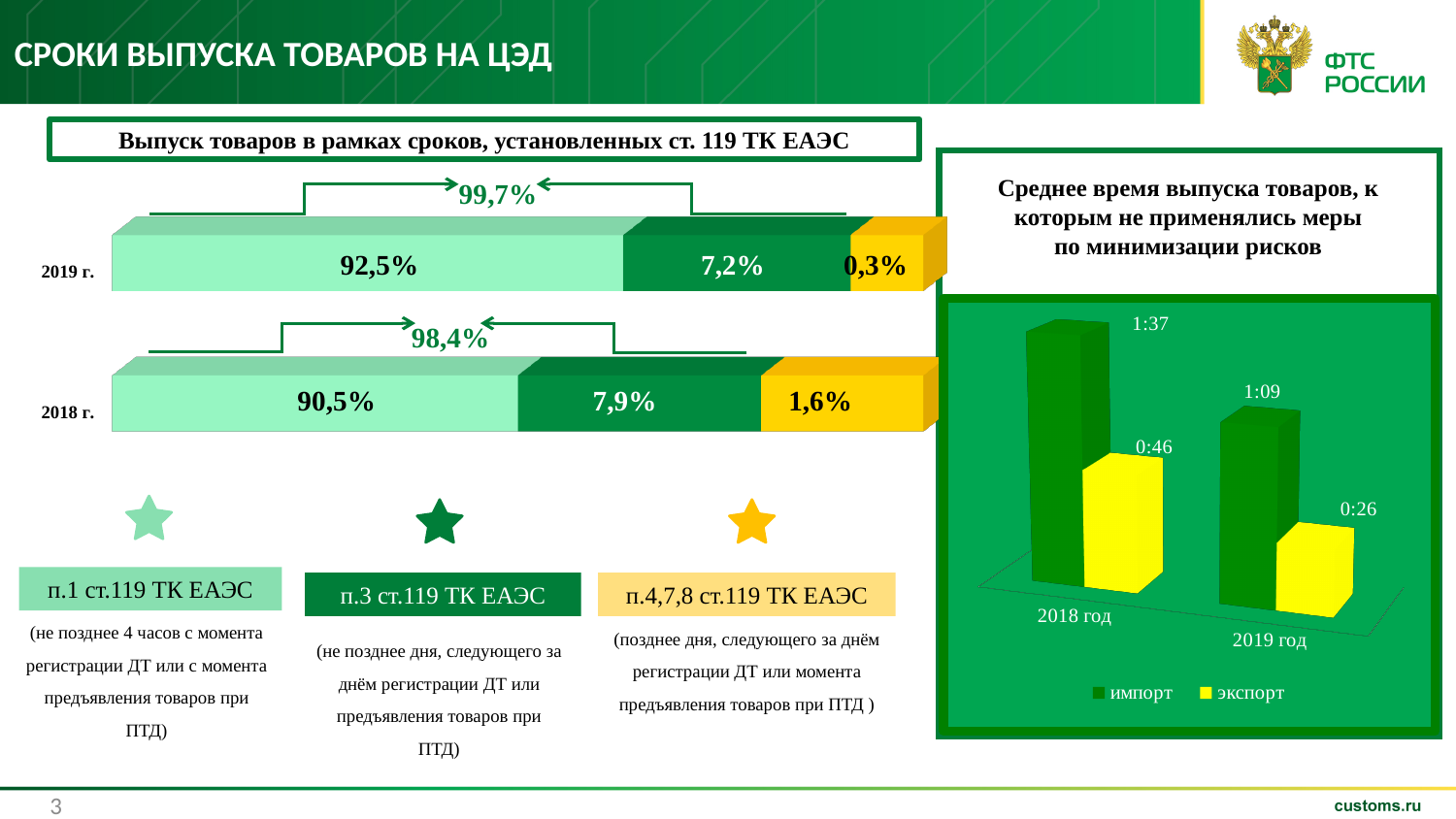
In the left chart 'Выпуск товаров в рамках сроков, установленных ст. 119 ТК ЕАЭС', what is the difference between the light green segments for 2019 г. and 2018 г.? 2,0 percentage points In the right chart 'Среднее время выпуска товаров, к которым не применялись меры по минимизации рисков', how many series does the legend list? 2 In the right chart 'Среднее время выпуска товаров, к которым не применялись меры по минимизации рисков', what is the value for импорт in 2018 год? 1:37 In the right chart 'Среднее время выпуска товаров, к которым не применялись меры по минимизации рисков', which bar is the highest? импорт, 2018 год In the left chart 'Выпуск товаров в рамках сроков, установленных ст. 119 ТК ЕАЭС', what combined value is shown by the bracket above the 2018 г. bar? 98,4% In the left chart 'Выпуск товаров в рамках сроков, установленных ст. 119 ТК ЕАЭС', how many years are shown? 2 In the right chart 'Среднее время выпуска товаров, к которым не применялись меры по минимизации рисков', do the values for импорт rise or fall from 2018 год to 2019 год? fall In the left chart 'Выпуск товаров в рамках сроков, установленных ст. 119 ТК ЕАЭС', what is the value of the yellow segment for 2018 г.? 1,6% In the left chart 'Выпуск товаров в рамках сроков, установленных ст. 119 ТК ЕАЭС', what is the value of the light green segment for 2019 г.? 92,5% In the left chart 'Выпуск товаров в рамках сроков, установленных ст. 119 ТК ЕАЭС', which year has the larger light green segment, 2019 г. or 2018 г.? 2019 г. In the right chart 'Среднее время выпуска товаров, к которым не применялись меры по минимизации рисков', what is the value for экспорт in 2019 год? 0:26 In the left chart 'Выпуск товаров в рамках сроков, установленных ст. 119 ТК ЕАЭС', what is the value of the dark green segment for 2019 г.? 7,2%